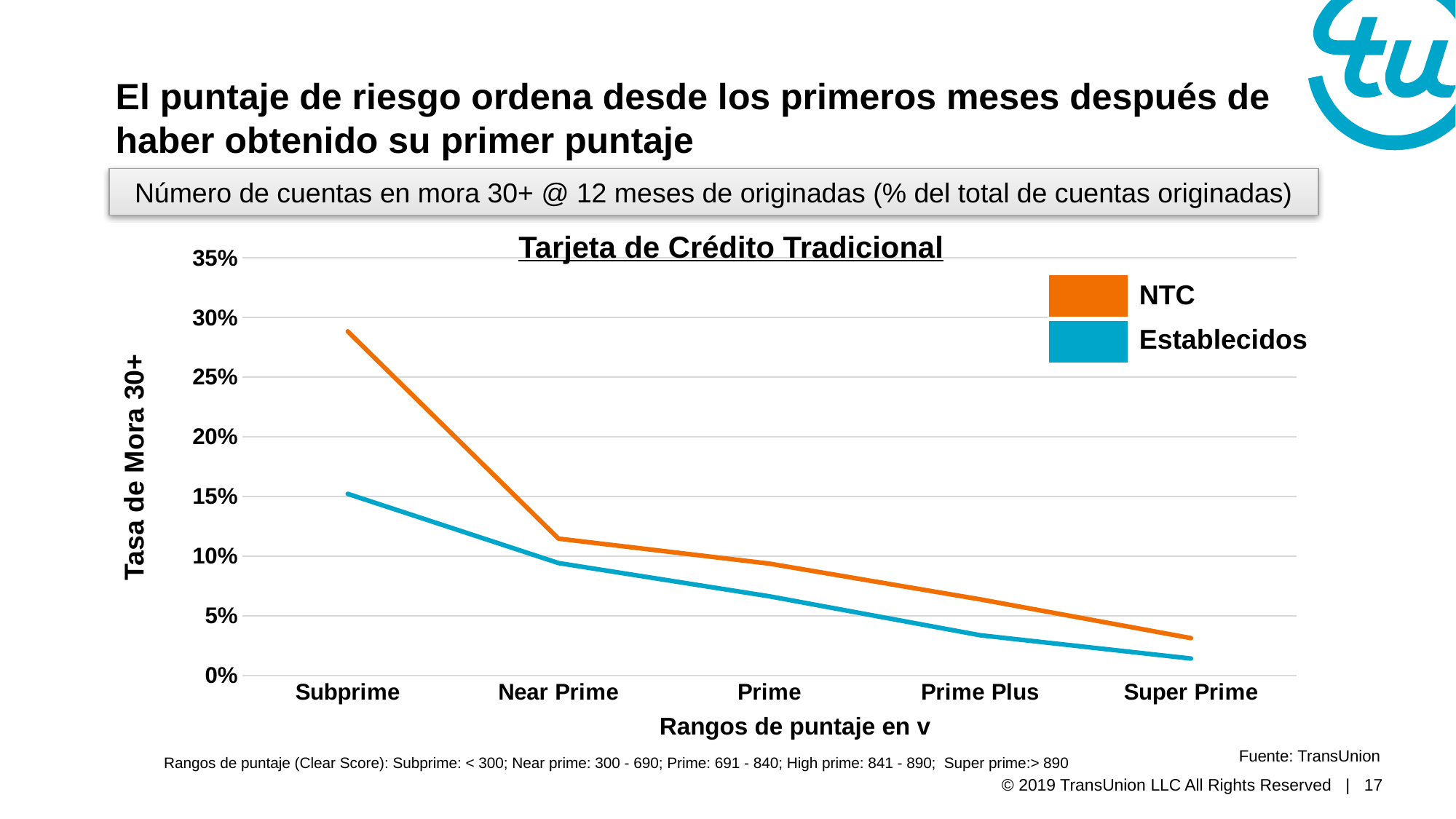
Which colour represents the Establecidos series? blue Do the NTC values rise or fall as the score range moves from Subprime to Super Prime? fall Which score range has the highest NTC delinquency rate? Subprime How many series does the legend list? 2 Is the NTC value for Super Prime greater or less than 5%? less Is the Establecidos value for Subprime greater or less than 20%? less How many score ranges are plotted along the x axis? 5 At Subprime, which series has the higher value, NTC or Establecidos? NTC Is the NTC value for Subprime greater or less than 25%? greater What is the title of the chart? Tarjeta de Crédito Tradicional Which score range has the lowest Establecidos delinquency rate? Super Prime What kind of chart is shown on the slide? line chart